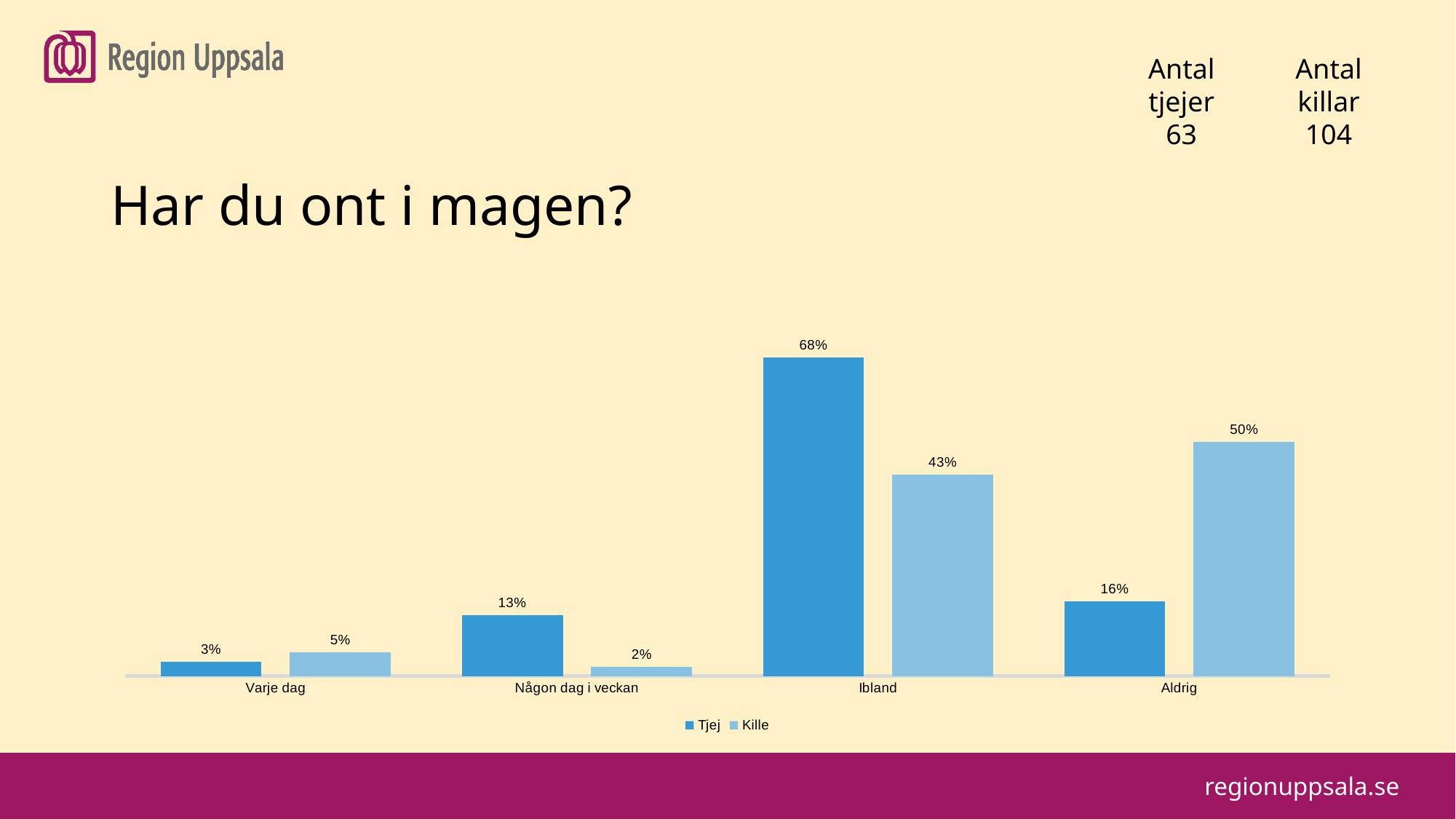
Which category has the highest value for Tjej? Ibland What is the difference between the Tjej and Kille values in the Ibland category? 25% What is the value for Tjej in the Ibland category? 68% Which category has the lowest value for Kille? Någon dag i veckan What is the value for Kille in the Någon dag i veckan category? 2% What is the title of the chart on the slide? Har du ont i magen? What is the value for Tjej in the Varje dag category? 3% What kind of chart is shown on the slide? Bar chart How many series does the legend list? 2 In the Aldrig category, which series has the larger value, Tjej or Kille? Kille What is the value for Kille in the Aldrig category? 50% How many categories are shown on the x axis? 4